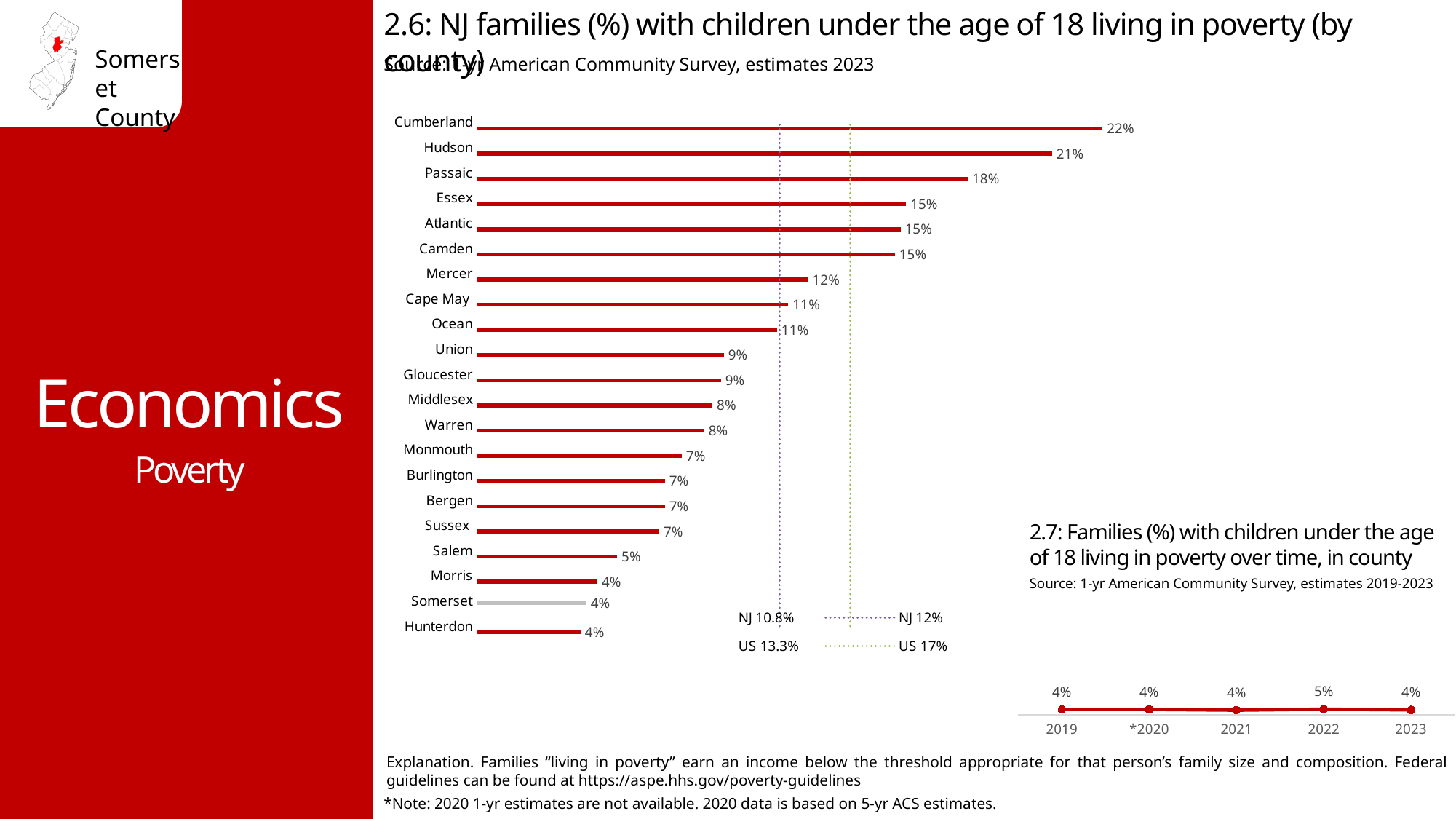
In chart 2.6 (by county), how many counties are plotted? 21 What kind of chart is chart 2.6 (by county)? Bar chart In chart 2.6 (by county), which is larger, the value for Mercer or the value for Union? Mercer What kind of chart is chart 2.7 (over time, in county)? Line chart In chart 2.6 (by county), what is the value for Somerset? 4% In chart 2.7 (over time, in county), how many years are plotted? 5 In chart 2.7 (over time, in county), which year has the highest value? 2022 In chart 2.6 (NJ families with children under 18 living in poverty by county), what is the value for Cumberland? 22% In chart 2.7 (families in poverty over time, in county), what is the value for 2022? 5% In chart 2.6 (by county), what is the difference between Hudson and Passaic? 3% In chart 2.6 (by county), which county has the highest value? Cumberland